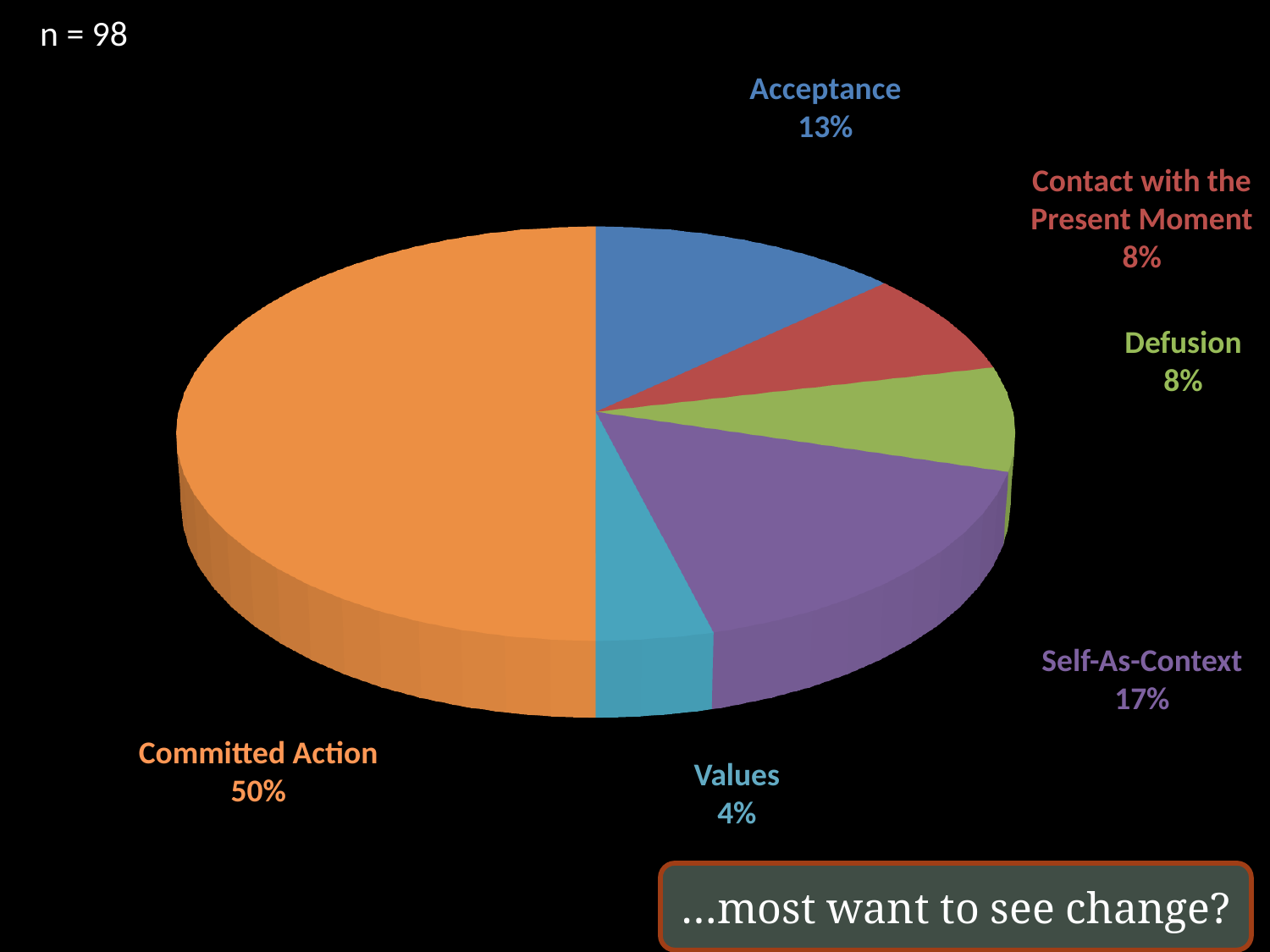
Which category has the smallest slice of the pie? Values What is the difference between the Committed Action share and the Self-As-Context share? 33% What sample size (n) is stated on the slide? n = 98 How many categories are shown in the pie chart? 6 What is the value shown for Self-As-Context? 17% Which category has the largest slice of the pie? Committed Action What is the value shown for Acceptance? 13% Which is larger, the share for Acceptance or the share for Defusion? Acceptance What is the value shown for Values? 4% What is the difference between the Acceptance share and the Values share? 9% What share of the pie does Committed Action represent? 50% What kind of chart is shown on the slide? pie chart